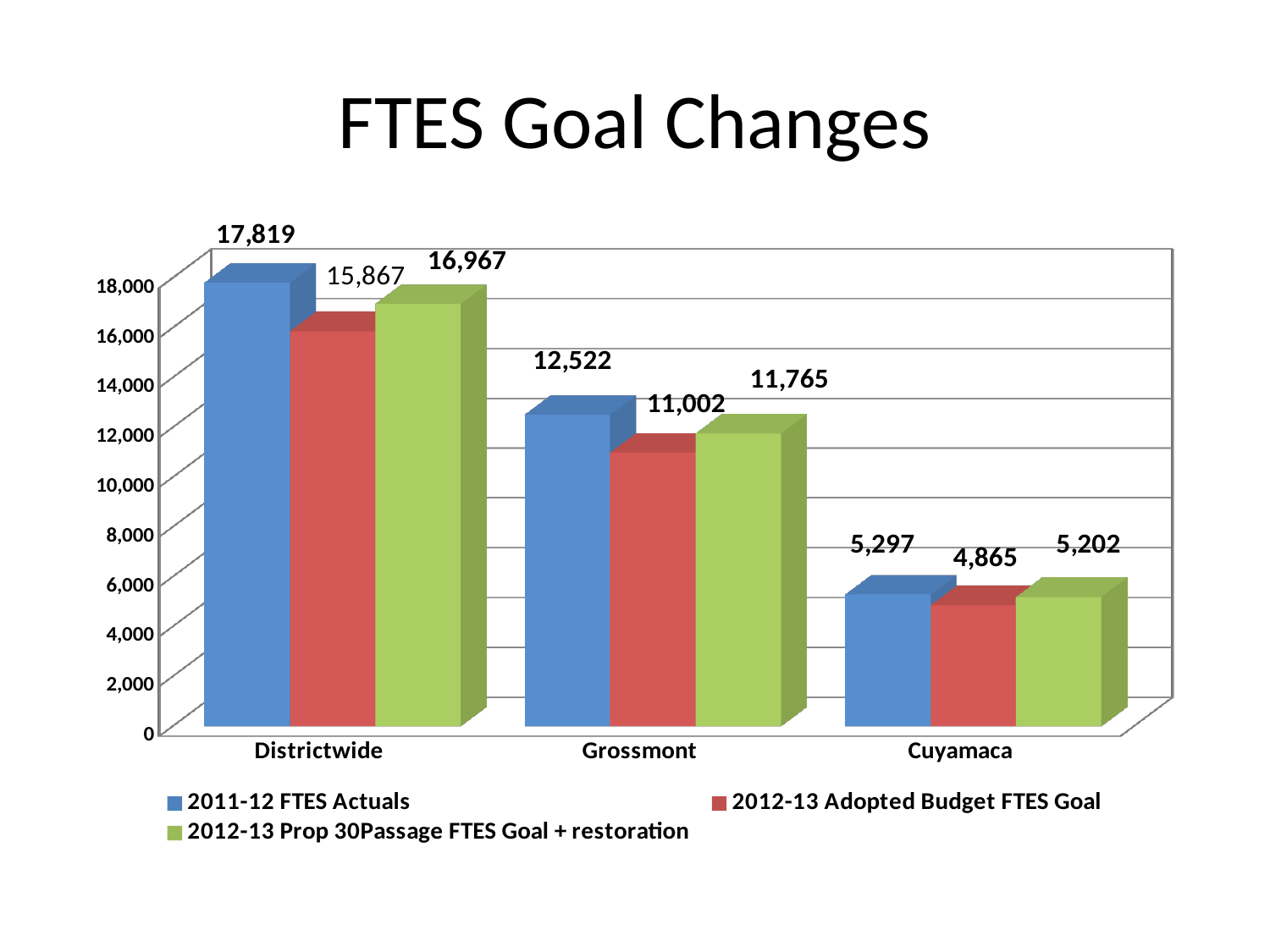
Which category has the highest 2011-12 FTES Actuals value? Districtwide Is the 2012-13 Adopted Budget FTES Goal for Districtwide greater or less than 16,000? less What is the 2012-13 Adopted Budget FTES Goal for Grossmont? 11,002 What type of chart is shown on the slide? Bar chart What is the 2012-13 Prop 30 Passage FTES Goal + restoration value for Cuyamaca? 5,202 What is the difference between the 2011-12 FTES Actuals and the 2012-13 Adopted Budget FTES Goal for Districtwide? 1,952 How many categories are shown on the x axis? 3 What is the difference between the 2012-13 Prop 30 Passage FTES Goal + restoration and the 2012-13 Adopted Budget FTES Goal for Grossmont? 763 Which category has the lowest 2012-13 Adopted Budget FTES Goal? Cuyamaca How many series does the legend list? 3 What is the 2011-12 FTES Actuals value for Districtwide? 17,819 For Cuyamaca, which is larger: the 2011-12 FTES Actuals or the 2012-13 Prop 30 Passage FTES Goal + restoration? 2011-12 FTES Actuals